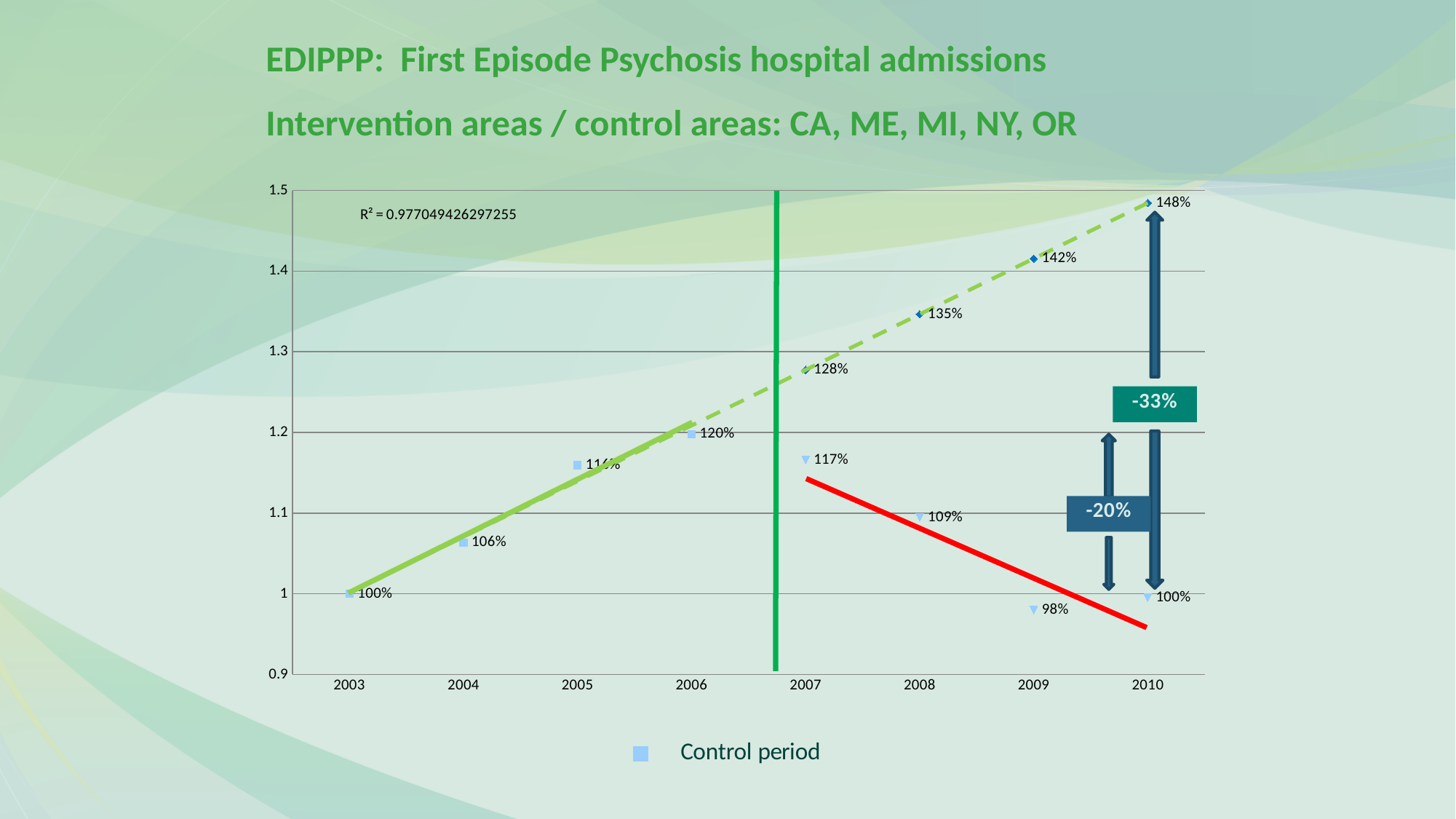
What is the difference between the upper series label and the lower series label in 2008? 26% Which year has the lowest labelled value on the lower (intervention) series? 2009 What is the data label on the lower (intervention) series in 2009? 98% What is the data label for the control period value in 2003? 100% What is the data label on the lower (intervention) series in 2007? 117% Which year has the highest labelled value on the upper (projected) series? 2010 In 2010, which is larger: the upper (projected) series value or the lower (intervention) series value? the upper (projected) series value Is the lower (intervention) series value in 2008 greater or less than 1.2 on the y axis? less How many years are shown on the x axis? 8 What is the data label on the upper (projected) series in 2010? 148% What is the data label for the control period value in 2006? 120% What R-squared value is printed on the chart? R² = 0.977049426297255